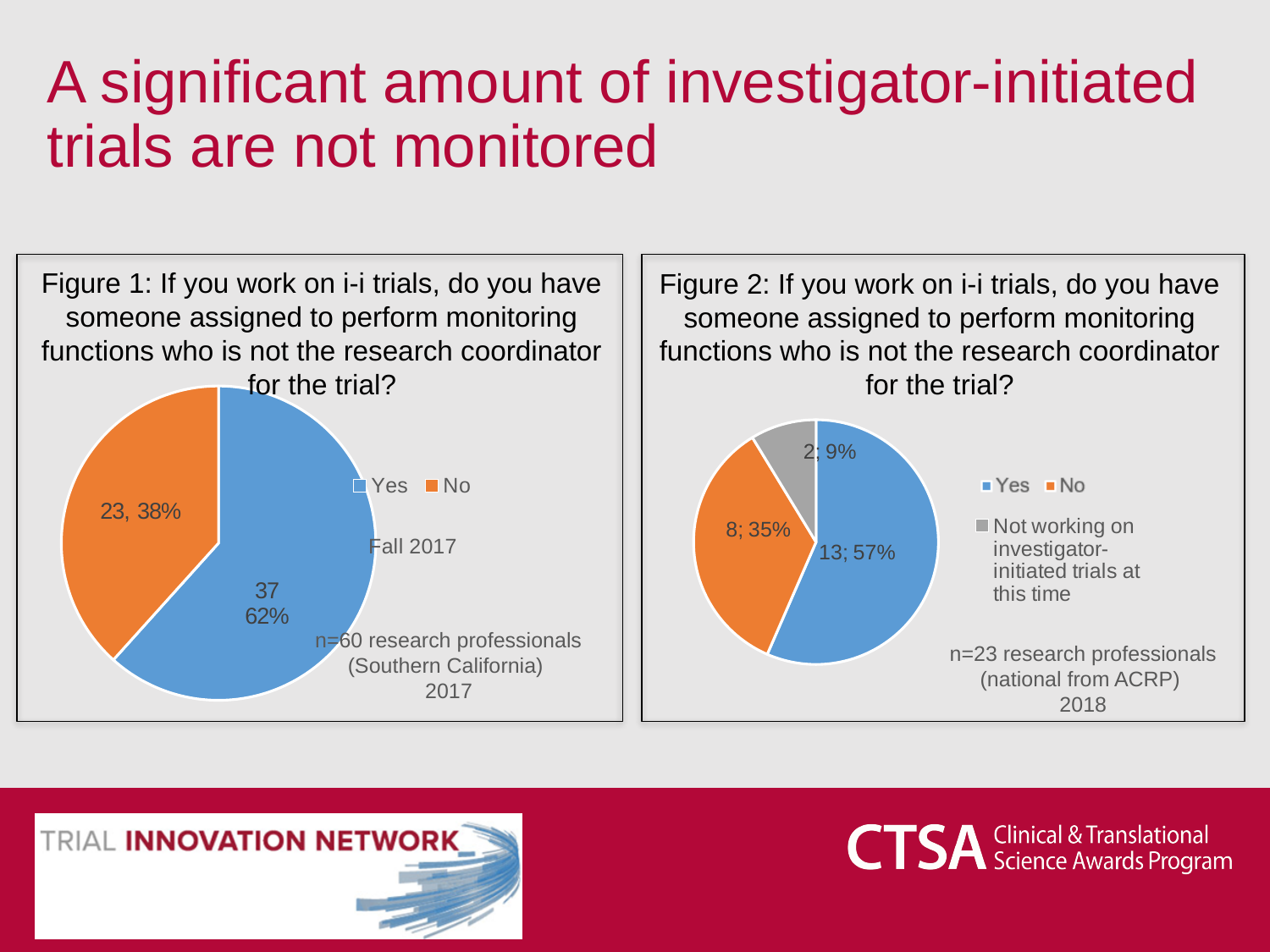
How many slices does the pie in Figure 2 have? 3 What type of chart is Figure 1? Pie chart In Figure 1, what percentage of respondents answered Yes? 62% In Figure 2, what share of the pie is the 'Not working on investigator-initiated trials at this time' slice? 9% In Figure 1, how many respondents answered No? 23 In Figure 1, what is the difference in count between Yes and No responses? 14 How many categories does the legend in Figure 1 list? 2 In Figure 1, which response has the larger share, Yes or No? Yes In Figure 2, what is the difference in count between Yes and No responses? 5 In Figure 2, how many respondents answered No? 8 In Figure 2, which category has the smallest slice? Not working on investigator-initiated trials at this time In Figure 2, what percentage of respondents answered Yes? 57%